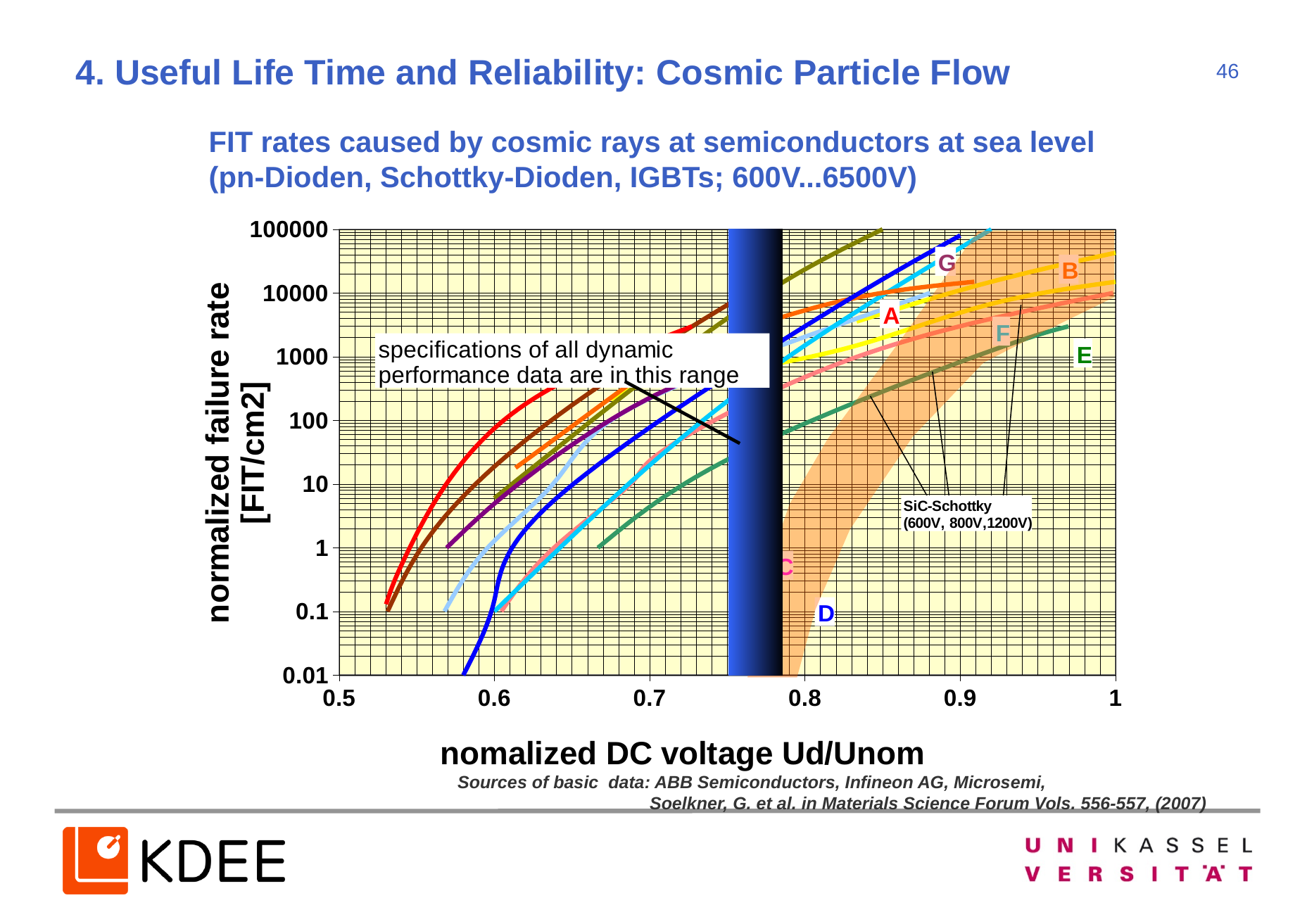
Is the value of curve B at a normalized DC voltage of 1 greater or less than 10000? greater What is the title of the y axis of the chart? normalized failure rate [FIT/cm2] What is the lowest tick value shown on the y axis? 0.01 What is the lowest value shown on the x axis? 0.5 What kind of chart is shown on the slide? line chart What is the highest value shown on the x axis? 1 Do the plotted curves rise or fall as the normalized DC voltage increases along the x axis? rise At the right end of the chart, which curve has the higher failure rate, B or E? B How many curves are labelled with a letter (A to G) on the chart? 7 Is the value of curve E at a normalized DC voltage of 0.9 greater or less than 100? greater What is the highest tick value shown on the y axis? 100000 What is the title of the x axis of the chart? nomalized DC voltage Ud/Unom